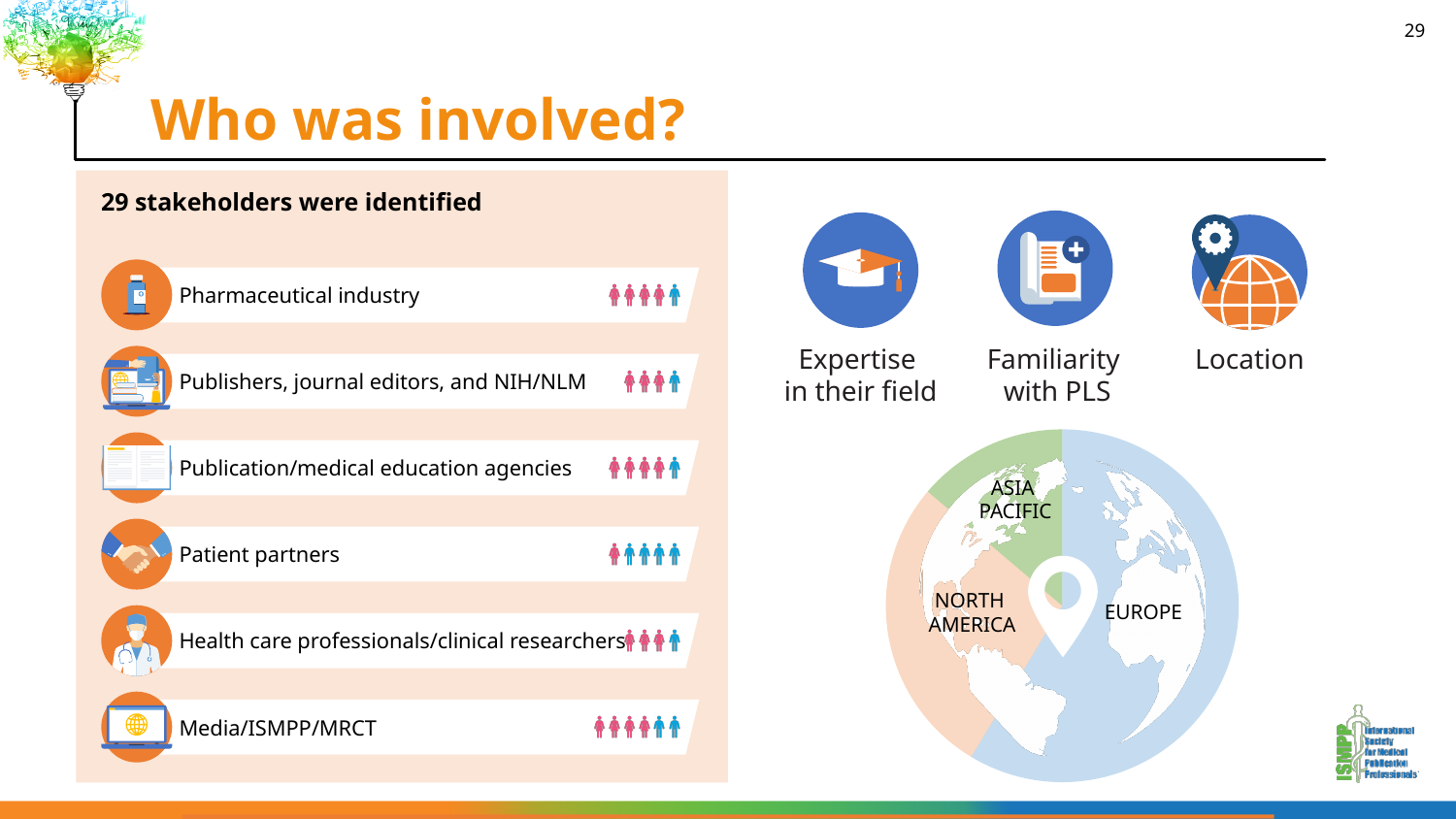
In the pictograph on the left, how many person icons are shown for Media/ISMPP/MRCT? 6 In the pictograph on the left, how many person icons are shown for Health care professionals/clinical researchers? 4 According to the heading above the pictograph on the left, how many stakeholders were identified in total? 29 How many stakeholder groups are listed in the pictograph on the left of the slide? 6 In the pictograph on the left, which stakeholder group has the most person icons? Media/ISMPP/MRCT In the pictograph on the left, which has more person icons: Patient partners or Health care professionals/clinical researchers? Patient partners What is the title of the slide? Who was involved? In the pictograph on the left, how many person icons are shown for Publishers, journal editors, and NIH/NLM? 4 In the pictograph on the left, what is the difference in the number of person icons between Media/ISMPP/MRCT and Publishers, journal editors, and NIH/NLM? 2 In the pictograph on the left, how many person icons are shown for Pharmaceutical industry? 5 How many regions are labelled on the globe chart on the right of the slide? 3 Which three regions are labelled on the globe chart on the right of the slide? Asia Pacific, North America, Europe